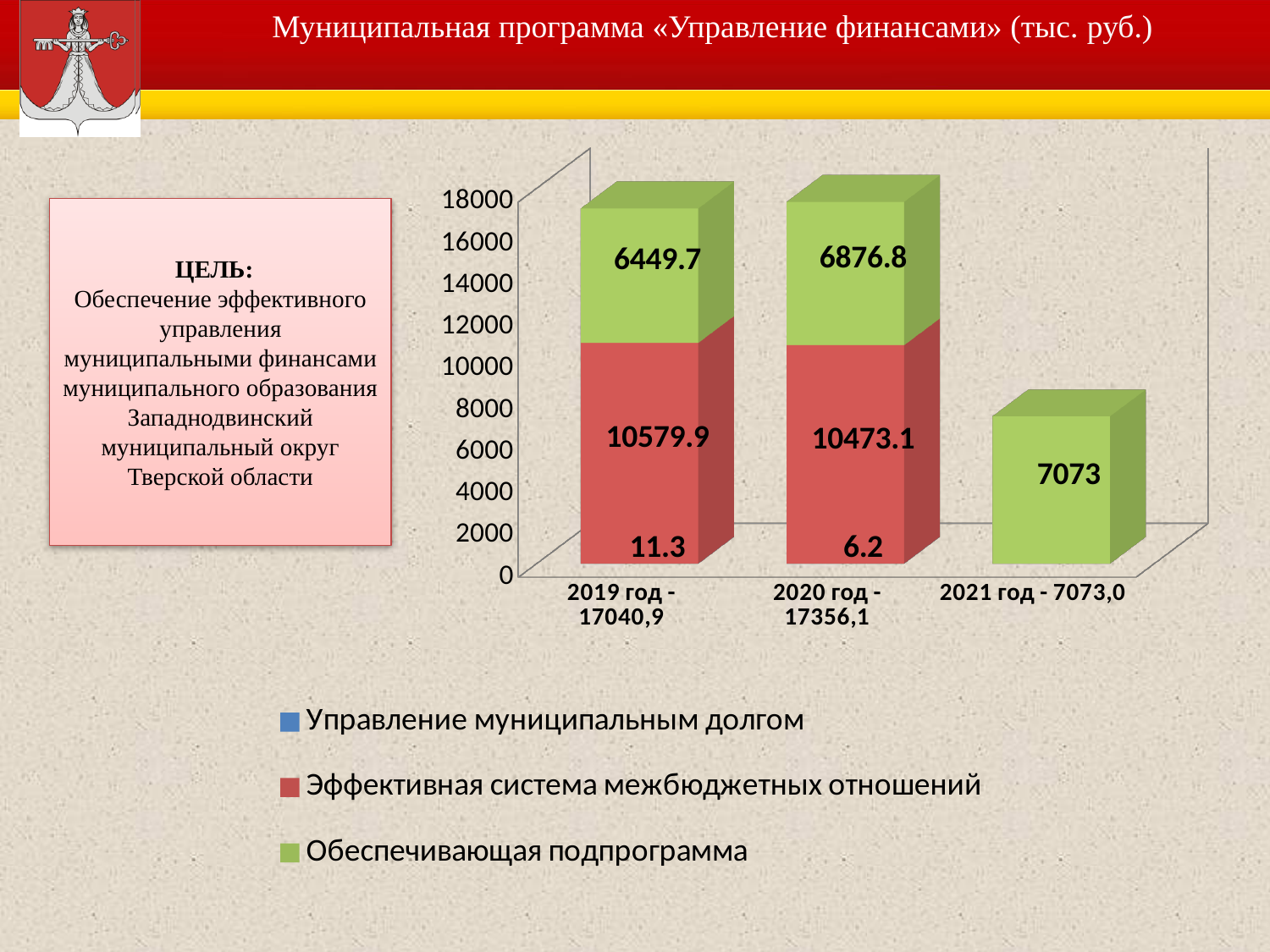
Which legend entry is shown in green? Обеспечивающая подпрограмма What is the value of «Обеспечивающая подпрограмма» for 2021 год? 7073 What is the value of «Эффективная система межбюджетных отношений» for 2019 год? 10579.9 Which is larger: «Эффективная система межбюджетных отношений» in 2019 год or in 2020 год? 2019 год Which year has the lowest total? 2021 год What type of chart is shown on the slide? stacked bar chart What is the difference between «Обеспечивающая подпрограмма» in 2020 год and 2019 год? 427.1 How many categories (years) are shown on the x axis? 3 What is the value of «Обеспечивающая подпрограмма» for 2020 год? 6876.8 What is the total of the stacked bar for 2020 год? 17356,1 How many series does the legend list? 3 What is the value of «Управление муниципальным долгом» for 2019 год? 11.3